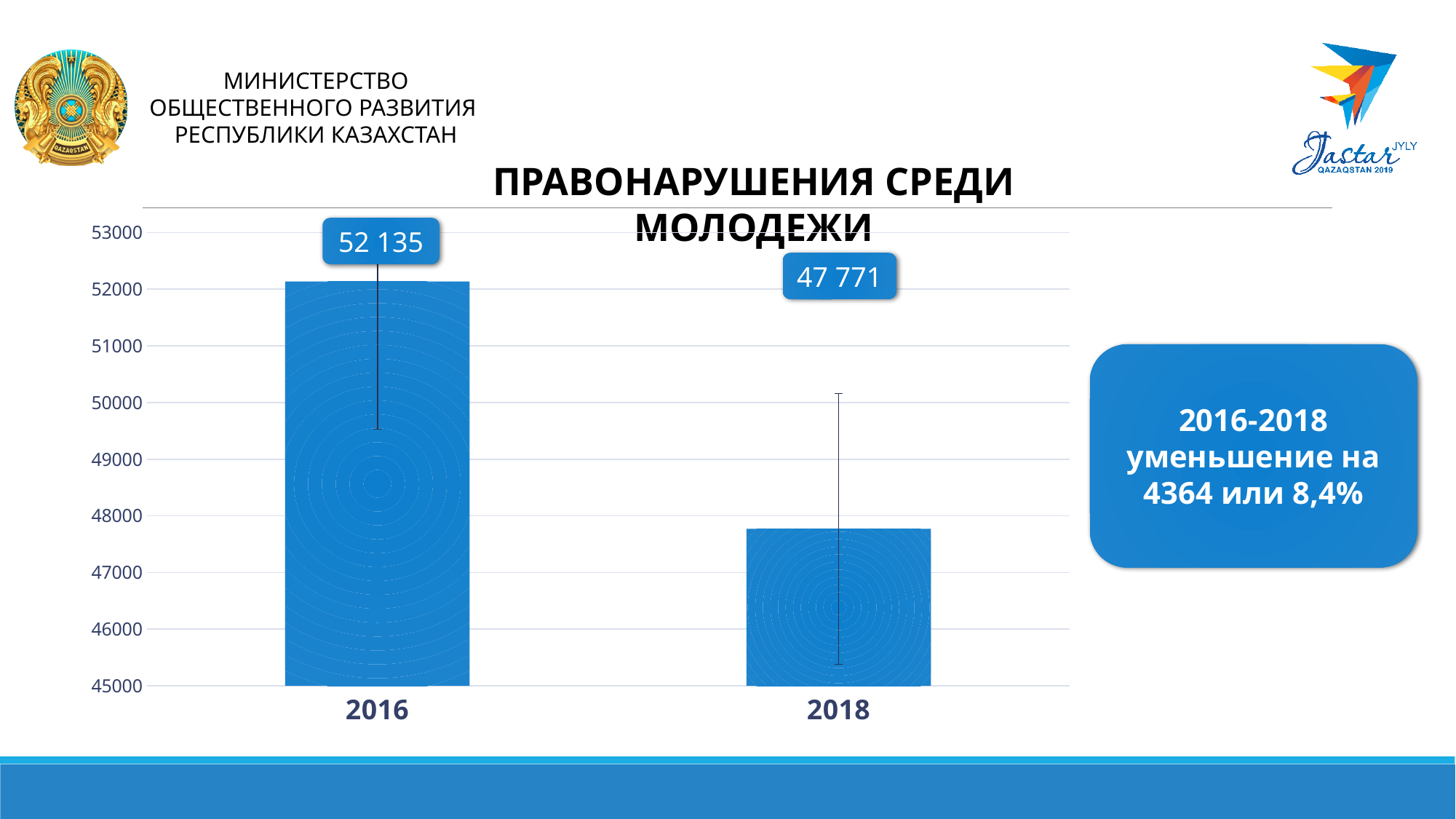
Is the value for 2016 larger or smaller than the value for 2018? larger What kind of chart is shown? bar chart What is the difference between the 2016 and 2018 values? 4364 How many years are shown on the chart? 2 Is the value for 2016 greater or less than 52000? greater What is the value for 2016? 52 135 Which year has the lower value? 2018 What is the value for 2018? 47 771 Is the value for 2018 greater or less than 48000? less What is the title of the chart? ПРАВОНАРУШЕНИЯ СРЕДИ МОЛОДЕЖИ Do the values rise or fall from 2016 to 2018? fall Which year has the higher value? 2016